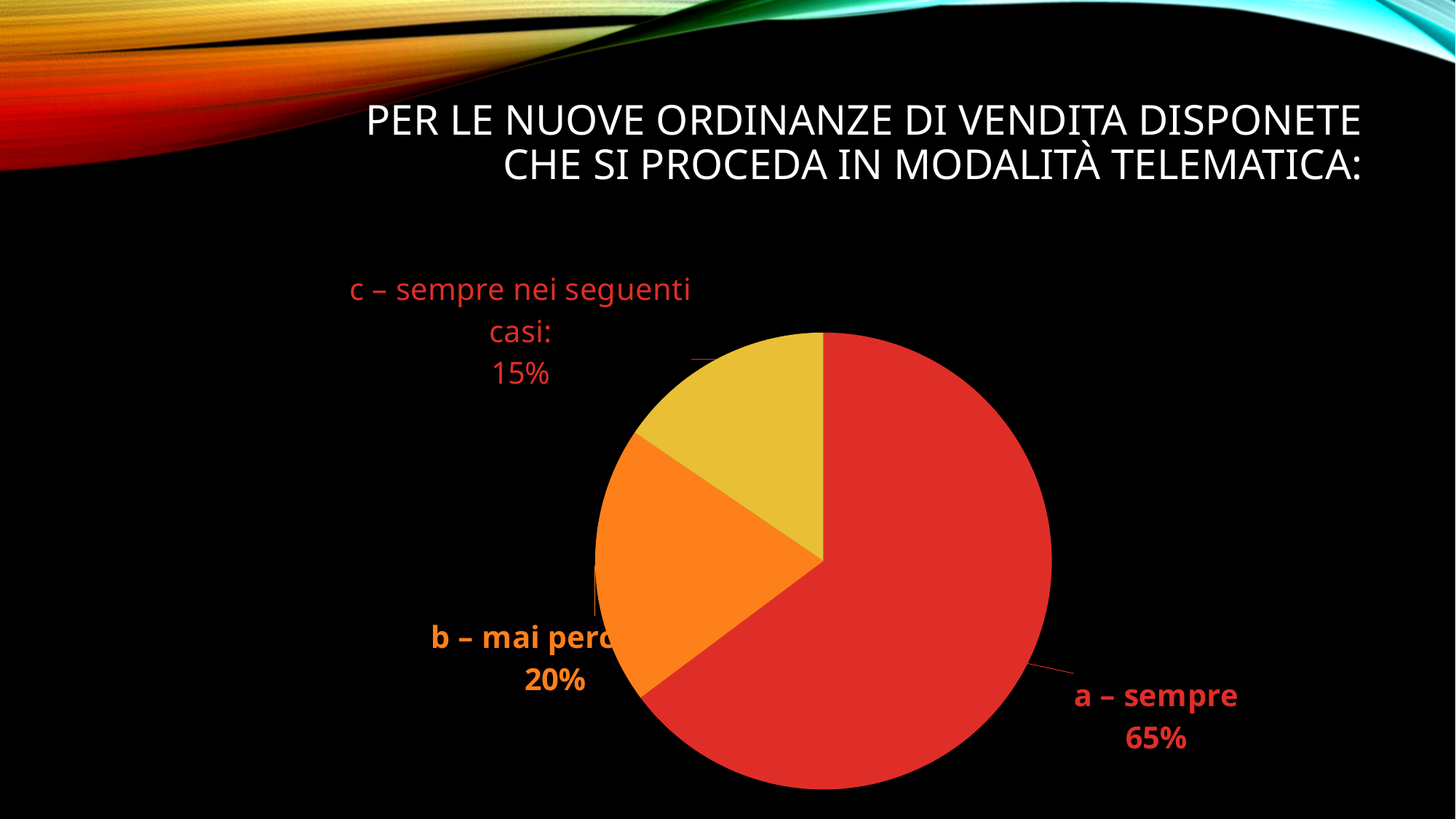
What colour is the "c – sempre nei seguenti casi:" slice of the pie chart? yellow What kind of chart is shown on the slide? pie chart What colour is the "a – sempre" slice of the pie chart? red Which slice of the pie chart is the largest? a – sempre How many slices does the pie chart have? 3 Which slice of the pie chart is the smallest? c – sempre nei seguenti casi: What is the combined share of the "b – mai" and "c – sempre nei seguenti casi:" slices? 35% What percentage is shown for the orange slice labelled "b – mai"? 20% What is the difference in percentage points between the "a – sempre" slice and the "b – mai" slice? 45 What percentage is shown for the slice labelled "a – sempre"? 65% Which is larger: the "b – mai" slice or the "c – sempre nei seguenti casi:" slice? b – mai What percentage is shown for the slice labelled "c – sempre nei seguenti casi:"? 15%